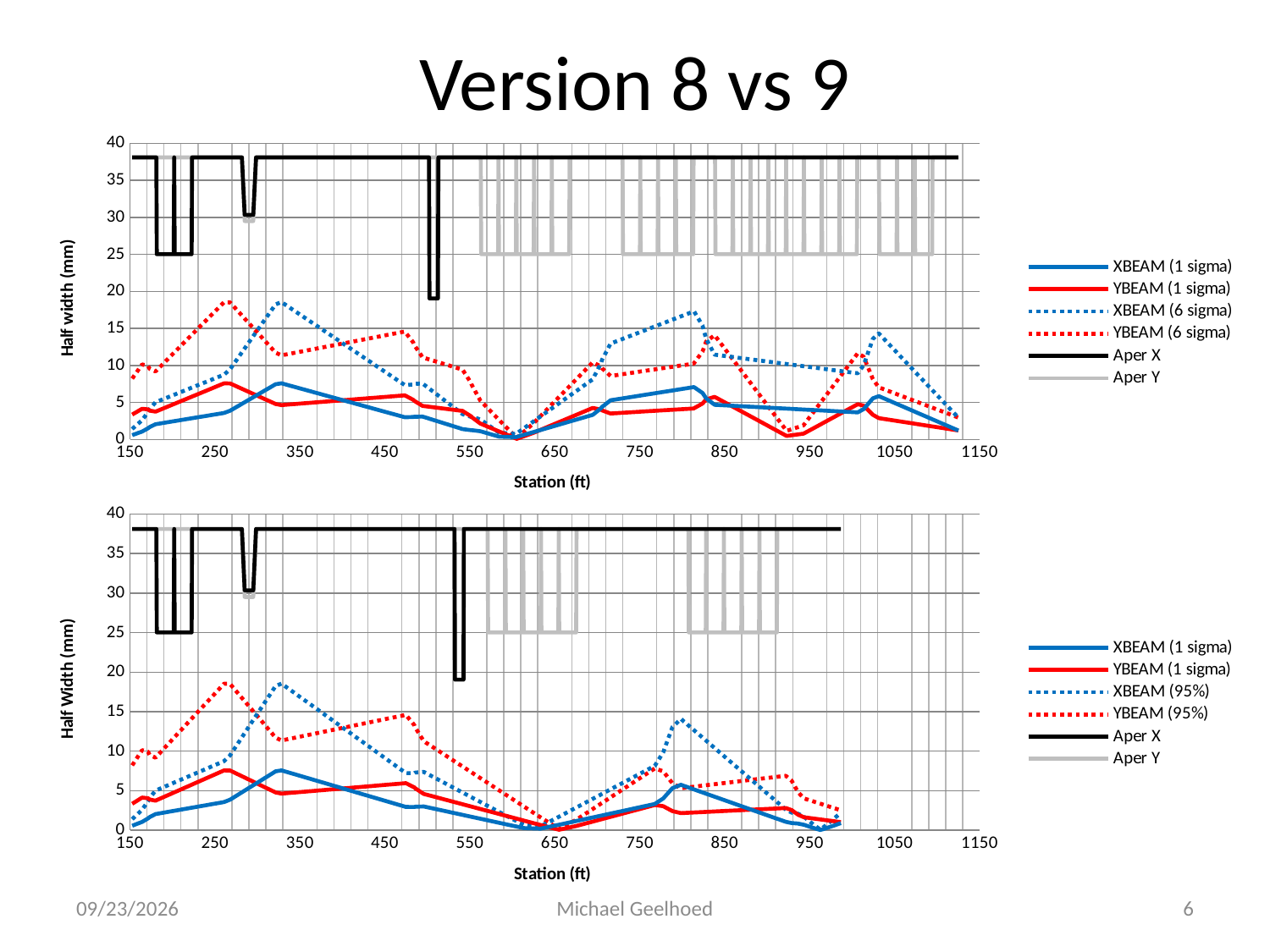
In the bottom chart, is the peak value of XBEAM (95%) near station 800 greater or less than 10? greater How many series does the legend of the bottom chart list? 6 In the top chart, is the peak value of XBEAM (6 sigma) near station 330 greater or less than 15? greater How many series does the legend of the top chart list? 6 What kind of chart is the top chart on the slide? line chart In the top chart, which series is shown as a dotted blue line? XBEAM (6 sigma) In the top chart, is the value of YBEAM (1 sigma) at station 930 greater or less than 5? less In the bottom chart, which series is shown as a dotted red line? YBEAM (95%) What kind of chart is the bottom chart on the slide? line chart